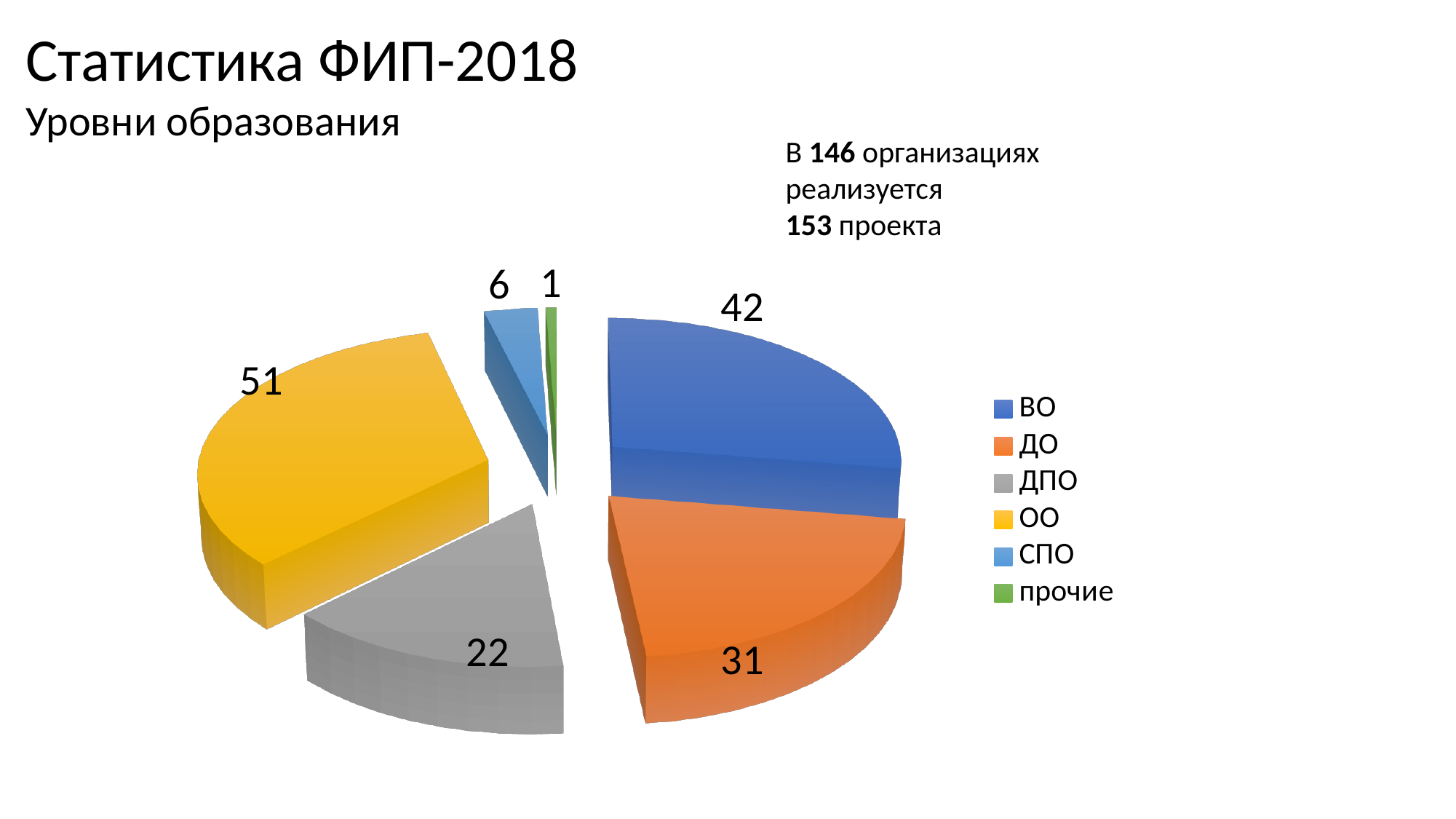
What is the difference between the values for ОО and ВО? 9 Which is larger, the value for ДО or the value for ДПО? ДО What is the value for СПО? 6 What is the value for ДПО? 22 Which category has the largest slice? ОО What type of chart is shown on the slide? pie chart How many categories does the legend list? 6 What is the total of all slices in the pie chart? 153 Which category has the smallest slice? прочие What is the value for ВО? 42 What is the value for ОО? 51 What share of the pie does ОО represent, to the nearest whole percent? 33%